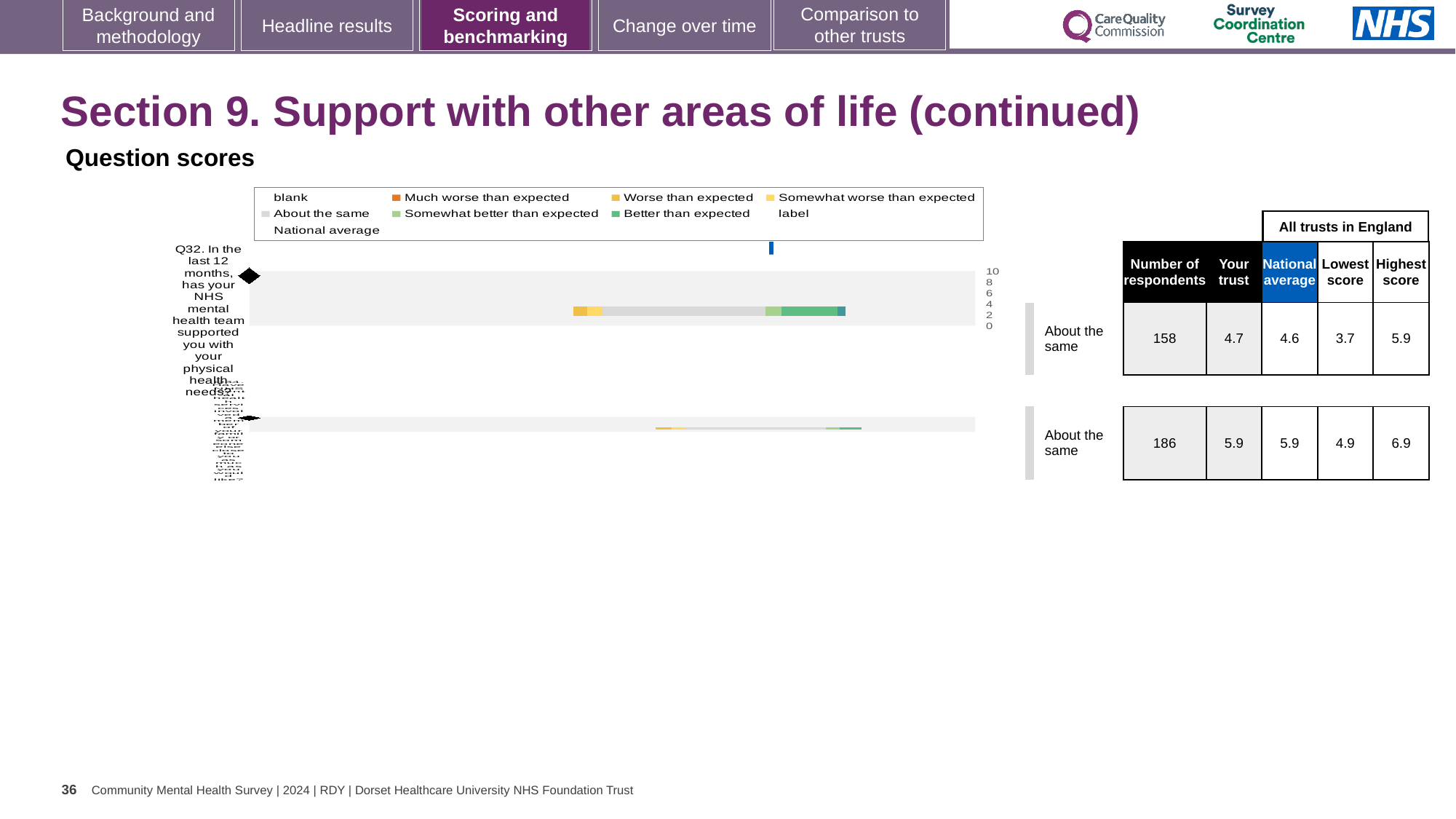
What is the highest score among all trusts in England for Q32? 5.9 What is the national average score for Q32? 4.6 Which benchmark category is Q32 assigned to in the chart? About the same What is the lowest score among all trusts in England for Q32? 3.7 What is the difference between the highest and lowest trust scores for Q32? 2.2 What is the 'Your trust' score for Q32 (support with physical health needs)? 4.7 How many entries does the chart legend list? 9 What colour does the legend use for 'Much worse than expected'? orange For Q32, which is larger: the 'Your trust' score or the national average? Your trust How many respondents answered Q32? 158 How many question rows are plotted in the chart? 2 What kind of chart is shown under 'Question scores'? bar chart